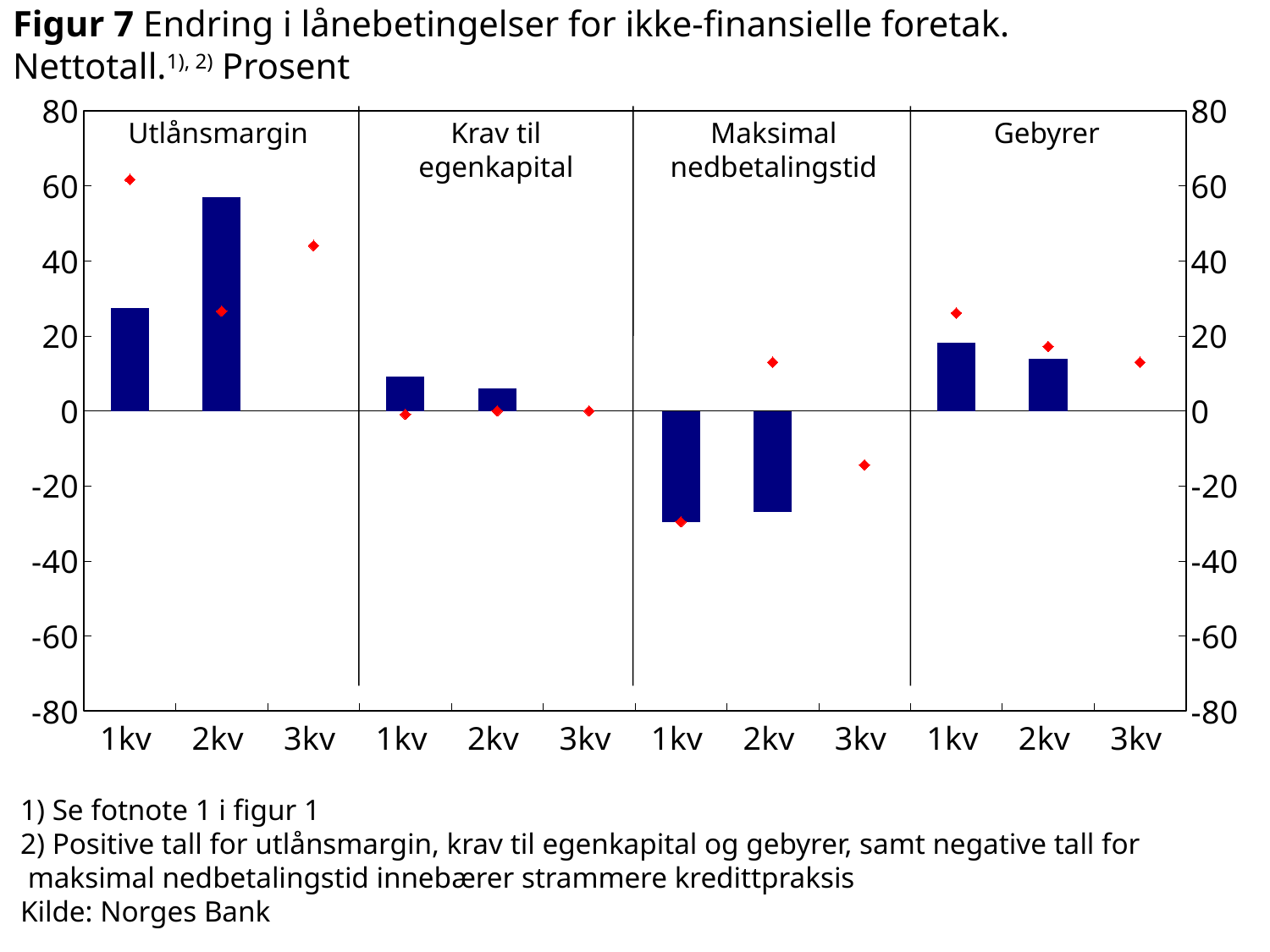
Is the bar for 1kv in the Utlånsmargin panel greater or less than 20? greater In the Utlånsmargin panel, which bar is larger, 1kv or 2kv? 2kv What source is cited for the chart? Norges Bank What kind of chart is shown on the slide? bar chart Which panel contains the lowest (most negative) bar? Maksimal nedbetalingstid How many panels (lending condition categories) does the chart have? 4 Is the bar for 1kv in the Krav til egenkapital panel greater or less than 20? less How many quarters are shown on the x axis within each panel? 3 Is the bar for 1kv in the Maksimal nedbetalingstid panel greater or less than -20? less Which panel contains the tallest bar? Utlånsmargin In the Gebyrer panel, which bar is larger, 1kv or 2kv? 1kv